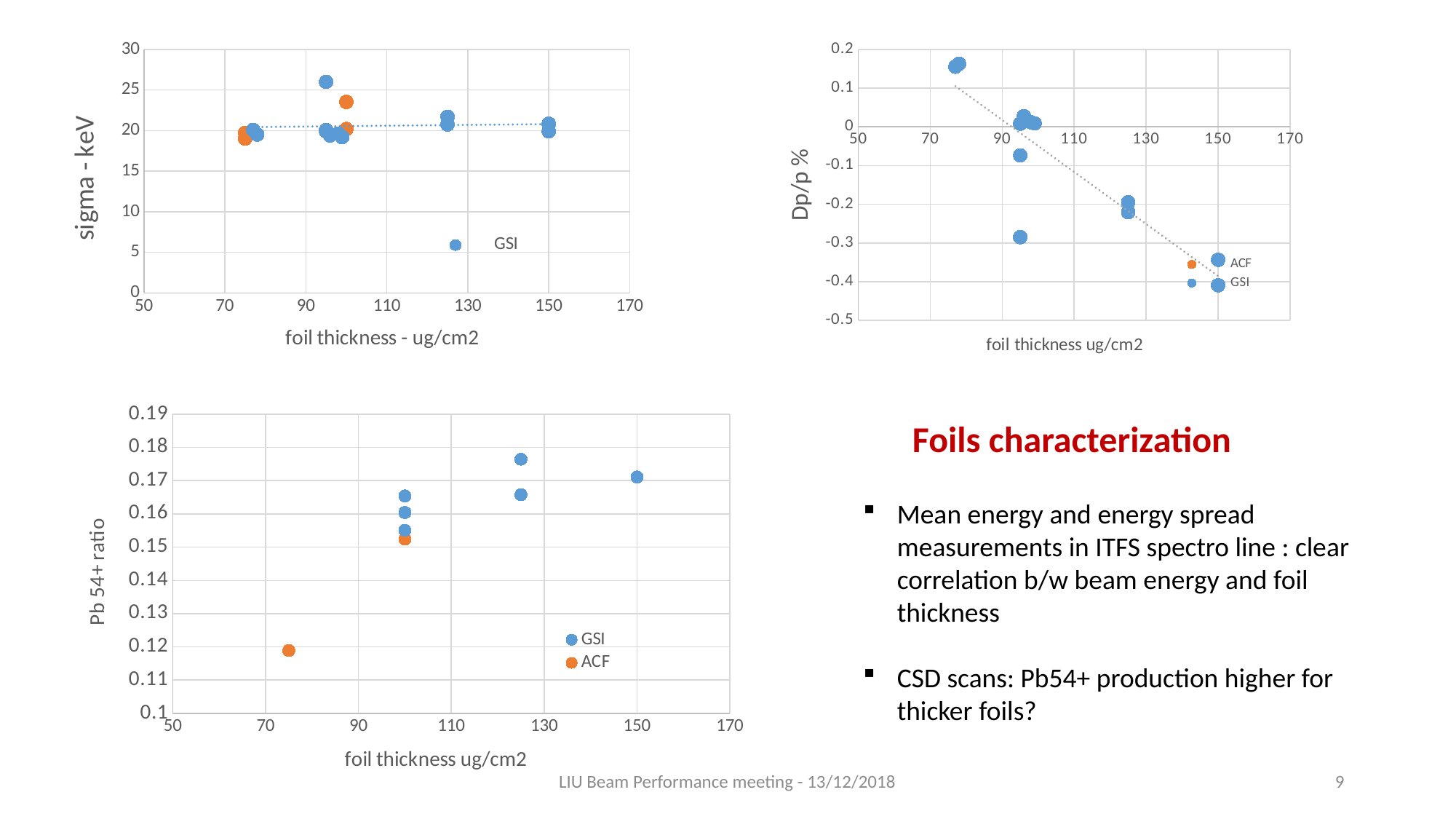
What type of chart is the bottom-left chart (Pb 54+ ratio vs foil thickness)? scatter chart What is the y-axis title of the top-left chart? sigma - keV In the top-right chart (Dp/p %), do the values generally rise or fall as foil thickness increases? fall In the bottom-left chart (Pb 54+ ratio), is the ACF value at foil thickness 75 greater or less than 0.13? less In the top-right chart (Dp/p %), is the value at foil thickness 150 greater or less than -0.3? less In the bottom-left chart (Pb 54+ ratio), is the GSI value at foil thickness 150 greater or less than 0.16? greater What is the x-axis title of the bottom-left chart? foil thickness ug/cm2 In the bottom-left chart (Pb 54+ ratio), do the values generally rise or fall as foil thickness increases? rise In the bottom-left chart (Pb 54+ ratio), how many ACF points are plotted? 2 How many series does the legend of the bottom-left chart (Pb 54+ ratio) list? 2 How many series does the legend of the top-right chart (Dp/p %) list? 2